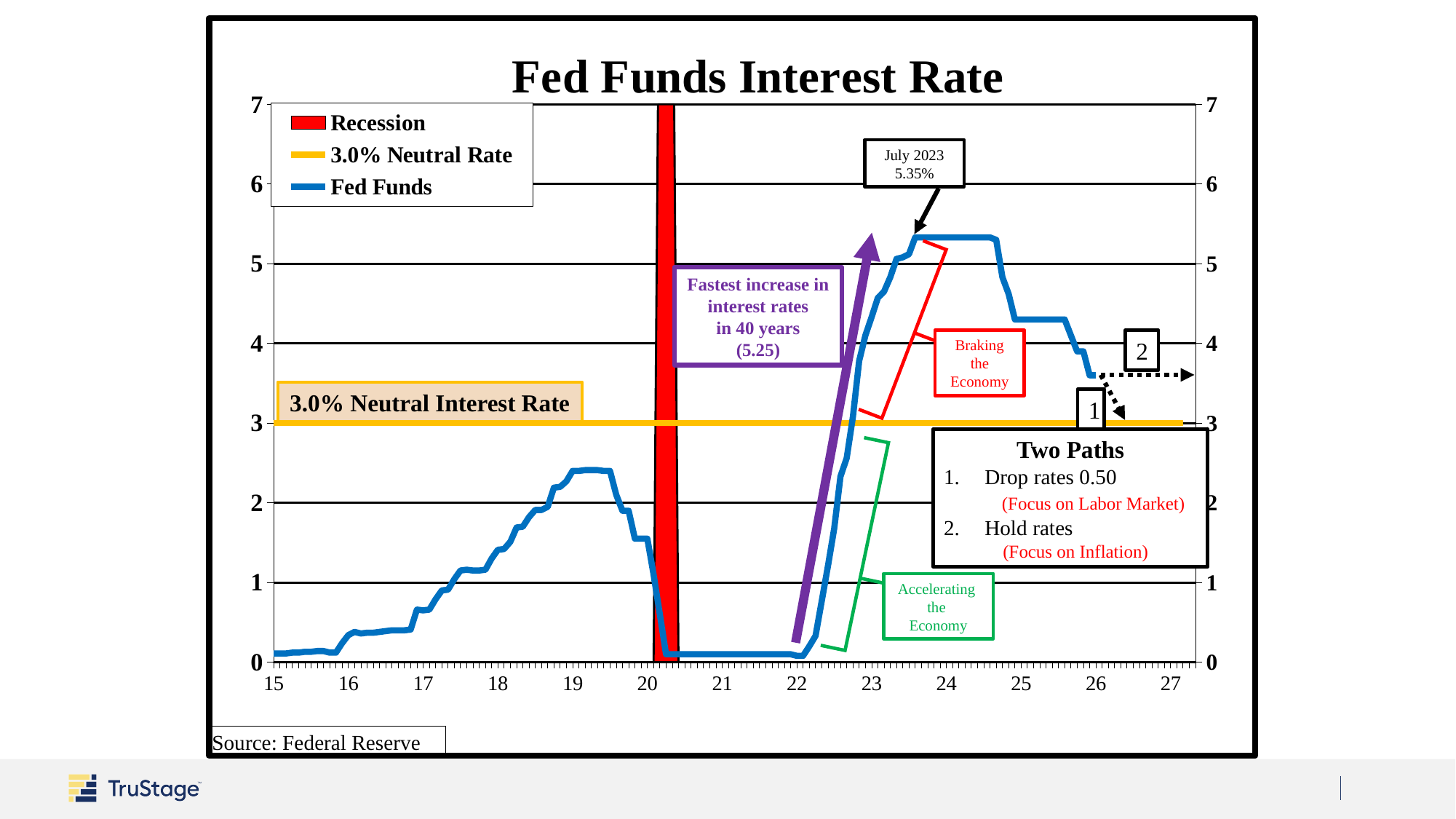
Does the Fed Funds line rise or fall between 2022 and 2023? Rise What is the title of the chart? Fed Funds Interest Rate According to the purple callout, how large was the fastest increase in interest rates in 40 years? 5.25 Is the Fed Funds rate in 2016 greater or less than 1? less Does the Fed Funds line rise or fall between 2024 and 2026? Fall Is the Fed Funds rate in 2021 greater or less than 1? less How many entries does the chart legend list? 3 What was the Fed Funds rate in July 2023, according to the callout on the chart? 5.35% Which is higher: the Fed Funds rate in 2019 or in 2024? 2024 What type of chart is shown on the slide? Line chart Is the Fed Funds rate at the start of 2019 greater or less than 2? greater What value is the neutral interest rate line drawn at? 3.0%